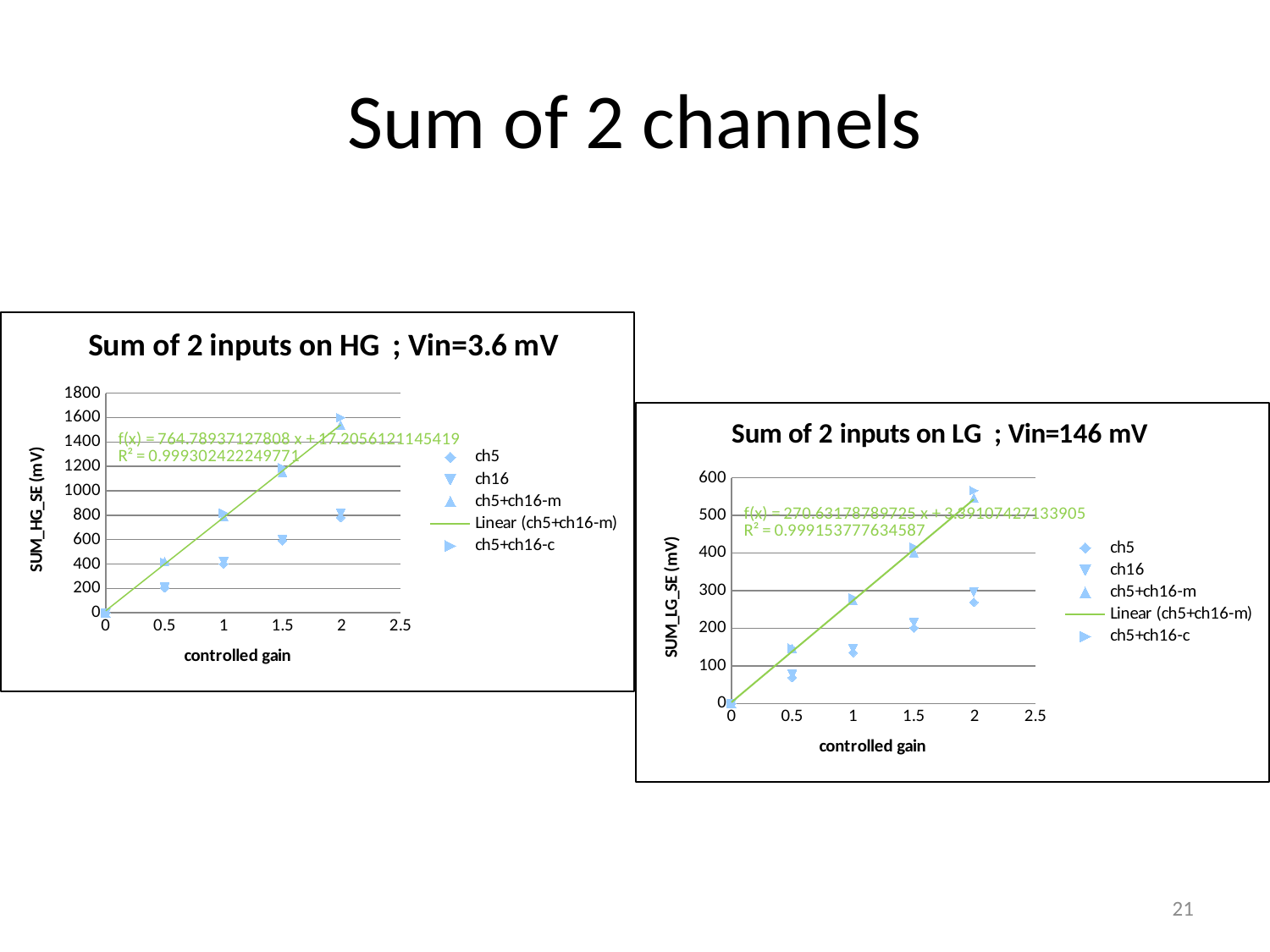
In the 'Sum of 2 inputs on HG ; Vin=3.6 mV' chart, at controlled gain 1.5, which is larger: ch5+ch16-m or ch16? ch5+ch16-m What is the x-axis label of the 'Sum of 2 inputs on LG ; Vin=146 mV' chart? controlled gain In the 'Sum of 2 inputs on LG ; Vin=146 mV' chart, is the value of ch5+ch16-c at controlled gain 2 greater or less than 500? greater What kind of chart is the 'Sum of 2 inputs on HG ; Vin=3.6 mV' chart? scatter chart In the 'Sum of 2 inputs on HG ; Vin=3.6 mV' chart, do the ch5+ch16-m values rise or fall as controlled gain increases? rise How many series does the legend of the 'Sum of 2 inputs on LG ; Vin=146 mV' chart list? 5 In the 'Sum of 2 inputs on LG ; Vin=146 mV' chart, at controlled gain 2, which is larger: ch5+ch16-m or ch5? ch5+ch16-m In the 'Sum of 2 inputs on LG ; Vin=146 mV' chart, is the value of ch16 at controlled gain 0.5 greater or less than 100? less In the 'Sum of 2 inputs on HG ; Vin=3.6 mV' chart, is the value of ch5+ch16-m at controlled gain 2 greater or less than 1400? greater What is the y-axis label of the 'Sum of 2 inputs on HG ; Vin=3.6 mV' chart? SUM_HG_SE (mV)